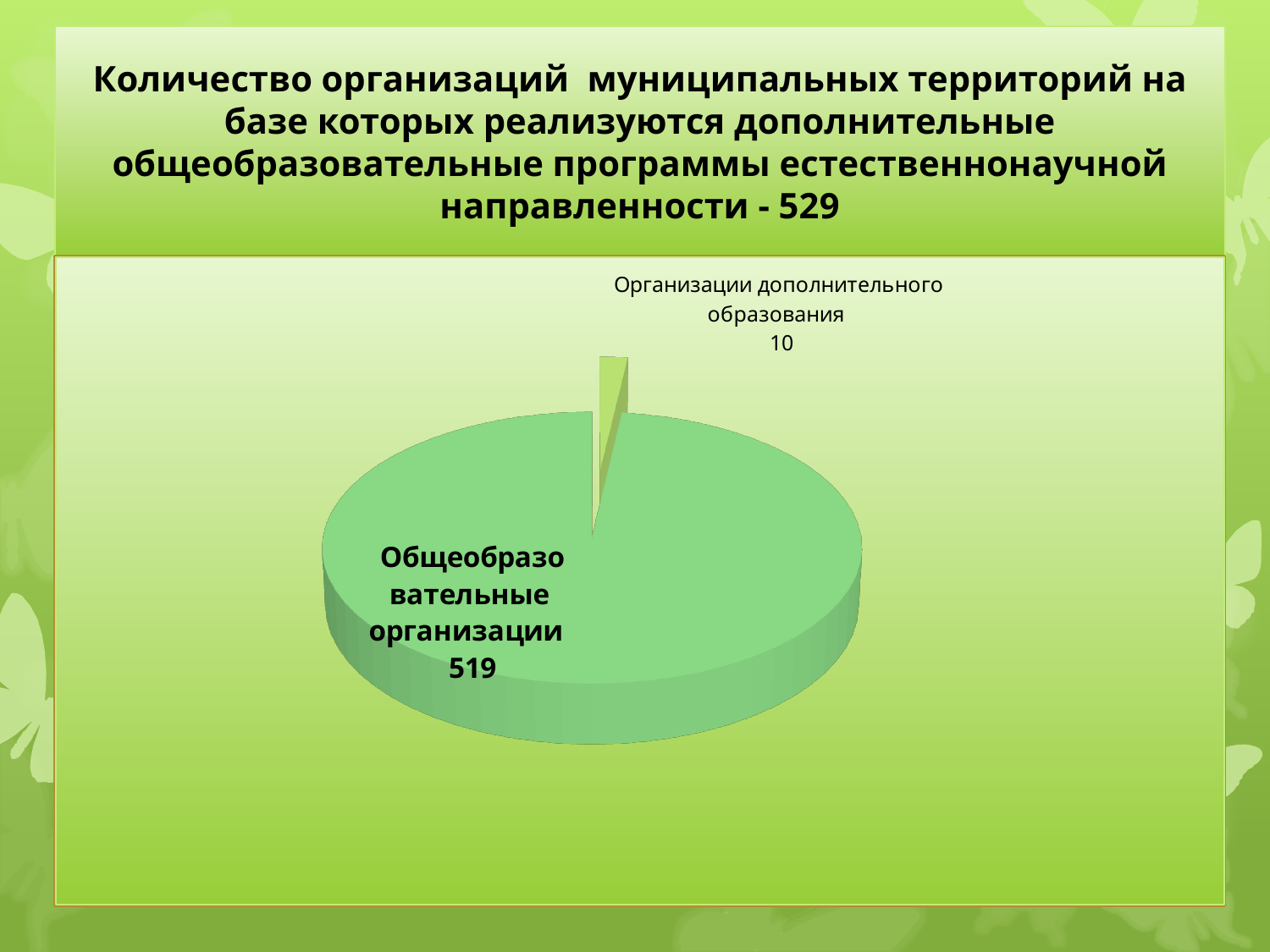
What is the total of the two slices in the pie chart? 529 What is the value for Общеобразовательные организации? 519 How many categories does the pie chart show? 2 What kind of chart is shown on the slide? pie chart What total number of organisations is stated in the slide title? 529 Is the pie chart drawn in 3D? yes Which category has the largest slice of the pie? Общеобразовательные организации What is the value for Организации дополнительного образования? 10 Which is larger: Общеобразовательные организации or Организации дополнительного образования? Общеобразовательные организации Which category has the smallest slice of the pie? Организации дополнительного образования What is the difference between the values for Общеобразовательные организации and Организации дополнительного образования? 509